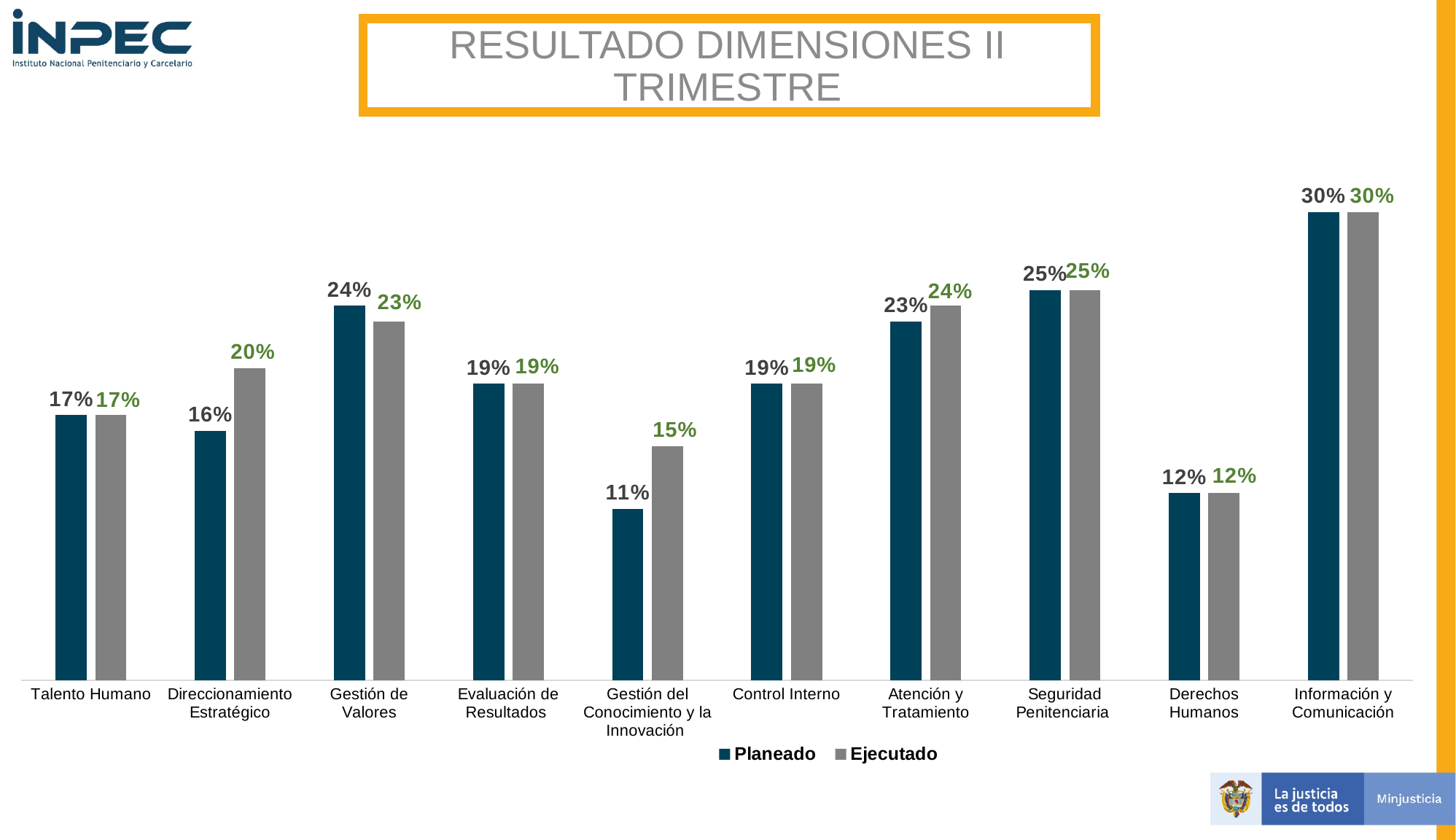
Which category has the highest Planeado value? Información y Comunicación How many series does the legend list? 2 What is the title of the chart? RESULTADO DIMENSIONES II TRIMESTRE What is the Ejecutado value for Direccionamiento Estratégico? 20% What is the Ejecutado value for Gestión del Conocimiento y la Innovación? 15% What kind of chart is shown on the slide? Bar chart Which series is shown in grey in the legend? Ejecutado What is the Planeado value for Gestión de Valores? 24% How many categories are shown on the x axis? 10 What is the difference between the Ejecutado and Planeado values for Gestión del Conocimiento y la Innovación? 4% Which category has the lowest Planeado value? Gestión del Conocimiento y la Innovación Which is larger for Gestión de Valores, the Planeado value or the Ejecutado value? Planeado